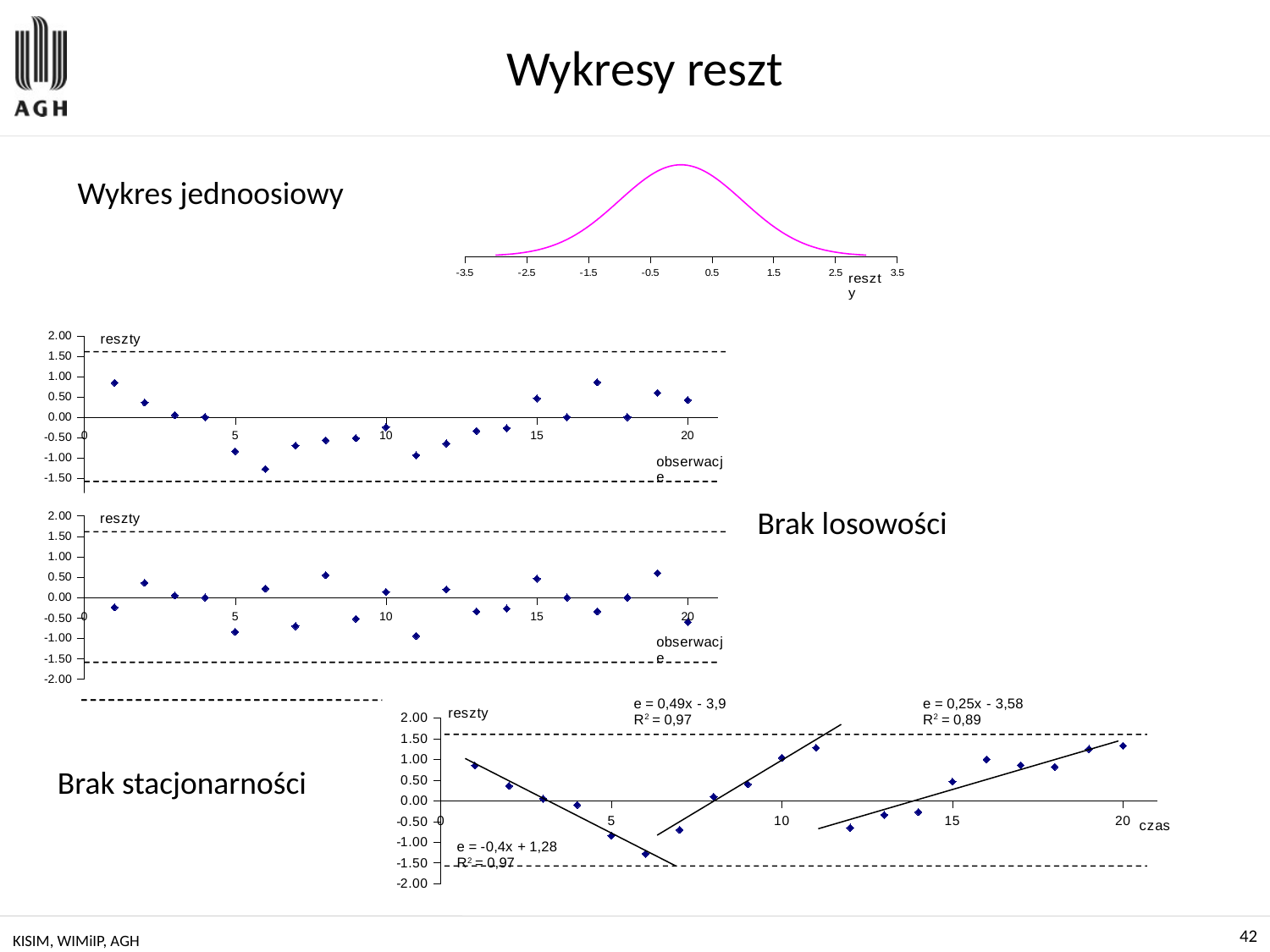
In the bottom-right chart (x axis labelled 'czas'), what R² value is printed for the middle fitted line (e = 0,49x - 3,9)? R² = 0,97 In the bottom-right chart (x axis labelled 'czas'), is the residual at time 11 greater or less than 1.00? greater In the first residual scatter chart (the top one of the three on the left), is the residual at observation 1 greater or less than 0.50? greater In the first residual scatter chart (the top one of the three on the left, x axis 'obserwacje'), at which observation is the residual lowest? 6 How many fitted trend lines are drawn in the bottom-right chart (x axis labelled 'czas')? 3 What is the label of the x axis in the bottom-right chart? czas In the bottom-right chart (x axis labelled 'czas'), what R² value is printed for the line e = 0,25x - 3,58? R² = 0,89 In the bottom-right chart (x axis labelled 'czas'), is the residual at time 6 greater or less than -1.00? less In the bottom-right chart (x axis labelled 'czas'), what is the equation of the fitted line on the right? e = 0,25x - 3,58 In the bottom-right chart (x axis labelled 'czas'), what is the equation of the first fitted line, printed at the lower left? e = -0,4x + 1,28 What is the title of the slide containing the residual charts? Wykresy reszt What kind of chart is the magenta curve at the top of the slide (x axis labelled 'reszty')? line chart